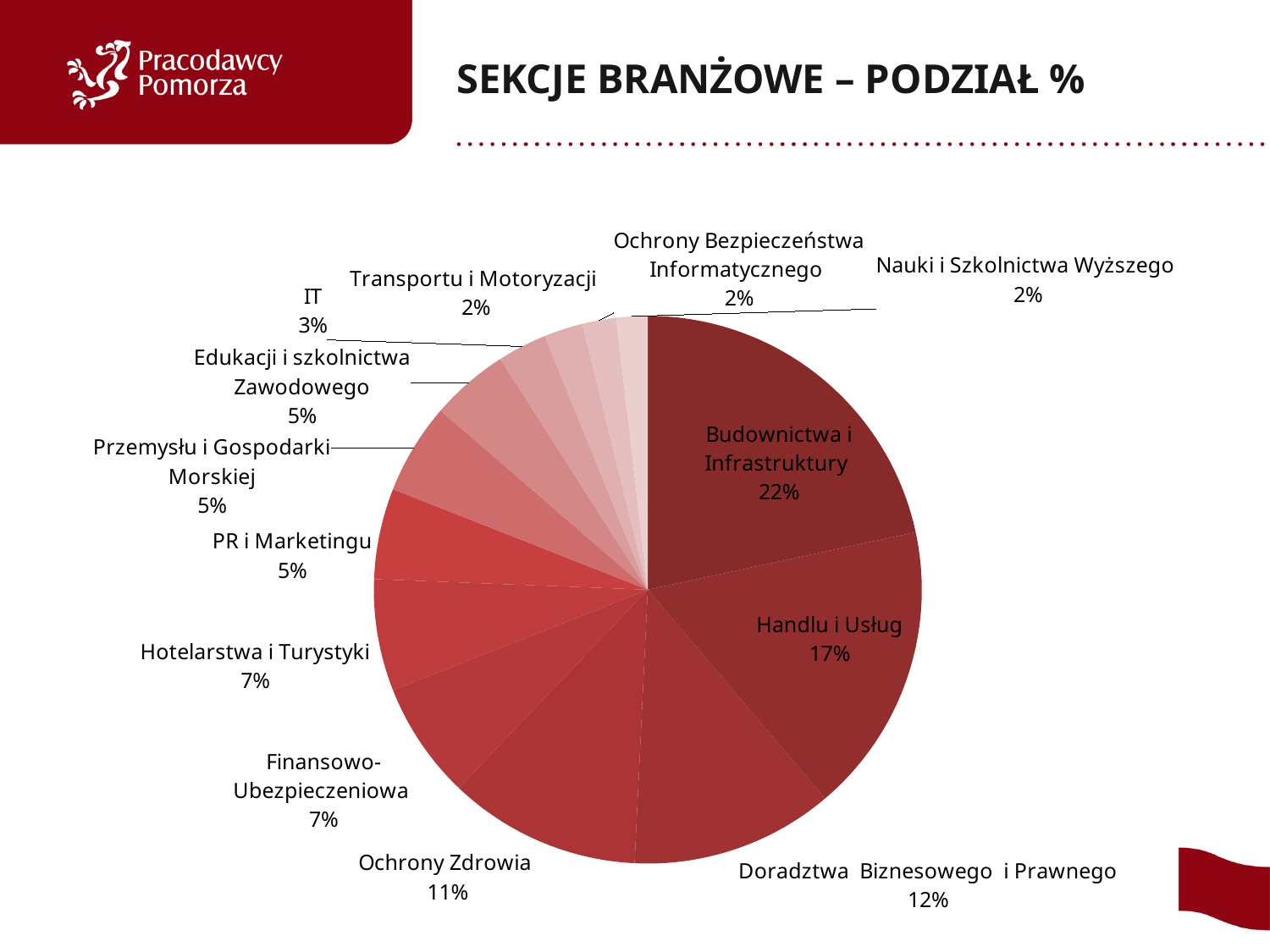
What is the difference in percentage points between Budownictwa i Infrastruktury and Handlu i Usług? 5 How many slices does the pie chart have? 13 Which section has the largest share in the pie chart? Budownictwa i Infrastruktury What is the value shown for Doradztwa Biznesowego i Prawnego? 12% What share does Budownictwa i Infrastruktury have in the pie chart? 22% Which is larger, the share for Ochrony Zdrowia or the share for Hotelarstwa i Turystyki? Ochrony Zdrowia What is the title of the chart on the slide? SEKCJE BRANŻOWE – PODZIAŁ % What is the combined share of Finansowo-Ubezpieczeniowa and Hotelarstwa i Turystyki? 14% What share does IT have in the pie chart? 3% What kind of chart is shown on the slide? pie chart What share does Handlu i Usług have? 17% What is the value shown for Ochrony Zdrowia? 11%